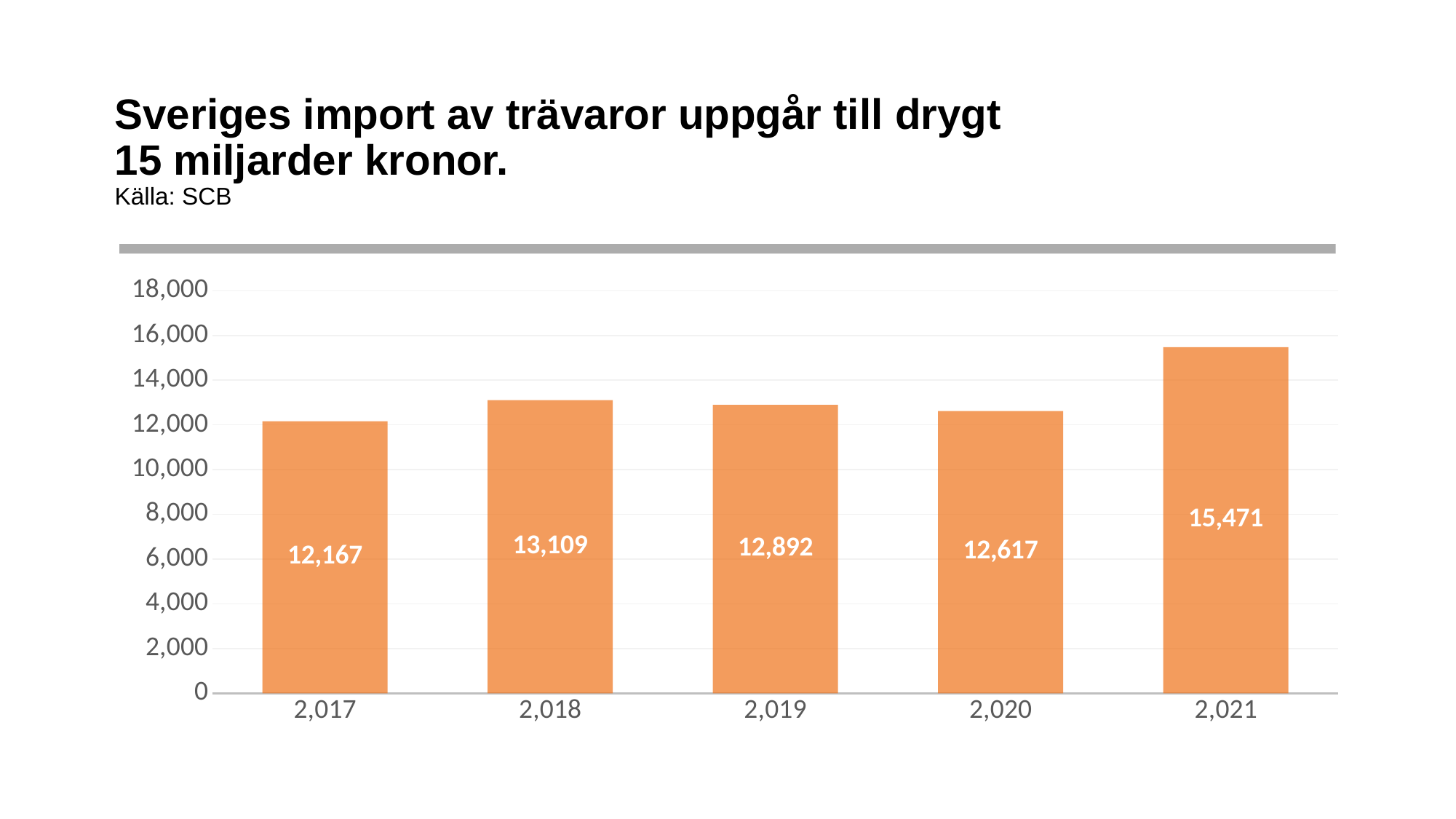
Is the value for 2,021 greater or less than 14,000? greater What kind of chart is shown on the slide? bar chart What is the value for 2,021? 15,471 What is the value for 2,017? 12,167 What is the difference between the values for 2,021 and 2,020? 2,854 What is the value for 2,019? 12,892 What is the difference between the values for 2,018 and 2,017? 942 Which year has the lowest value? 2,017 What is the source cited below the slide title? SCB Which is larger, the value for 2,018 or the value for 2,019? 2,018 How many bars are shown in the chart? 5 Which year has the highest value? 2,021